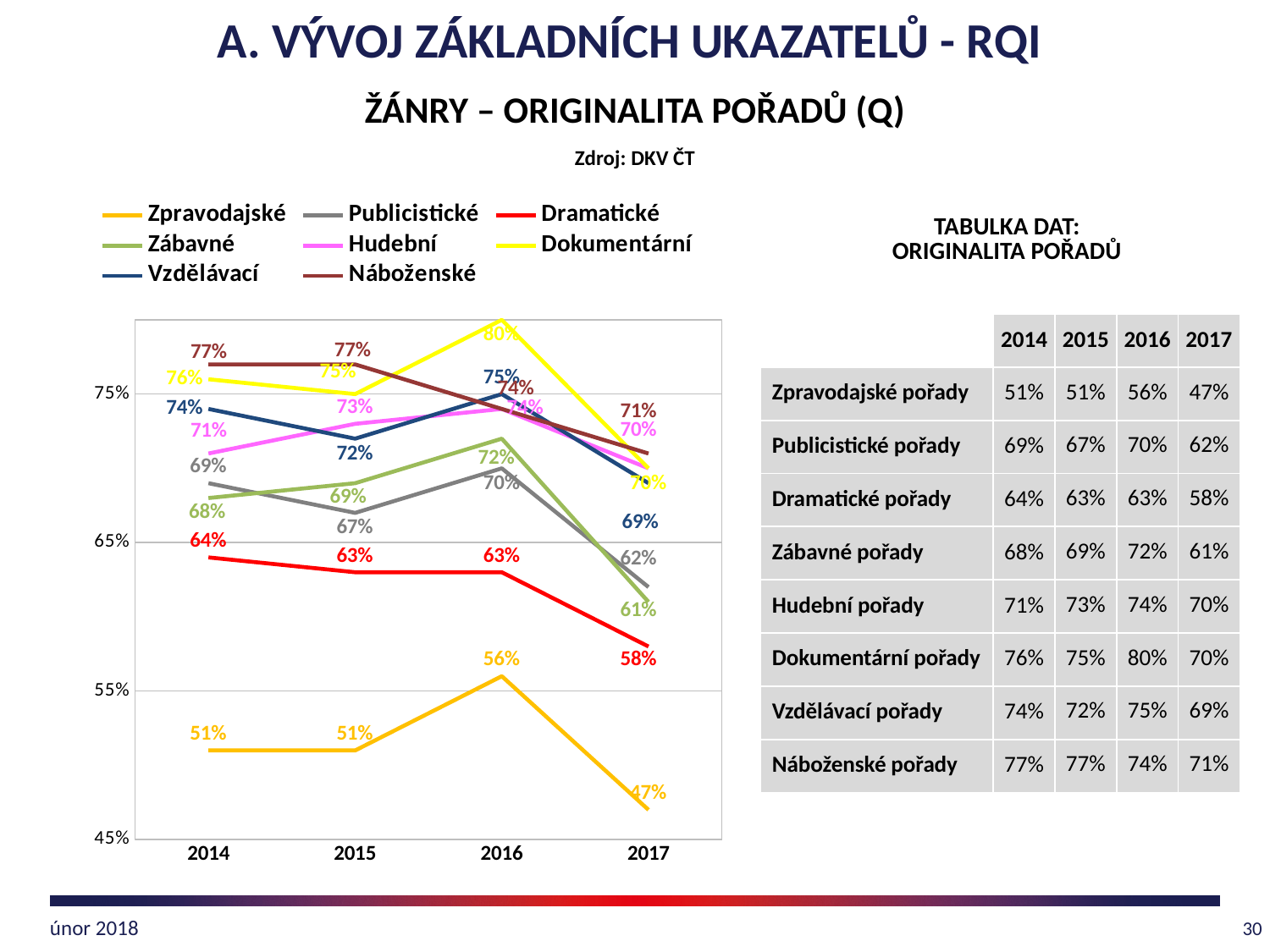
Is the value for Zpravodajské in 2017 greater or less than 55%? less Which series has the highest value in 2016? Dokumentární By how many percentage points did the Zpravodajské value fall from 2016 to 2017? 9 percentage points In 2014, which is larger: the value for Náboženské or the value for Hudební? Náboženské How many series does the chart legend list? 8 How many years are plotted along the x axis of the chart? 4 What source is cited for the chart data? DKV ČT What kind of chart is shown on the slide? line chart Does the Dramatické series rise or fall from 2014 to 2017? fall Which series has the lowest value in 2014? Zpravodajské What is the value for Dokumentární in 2016? 80% What is the value for Zpravodajské in 2017? 47%